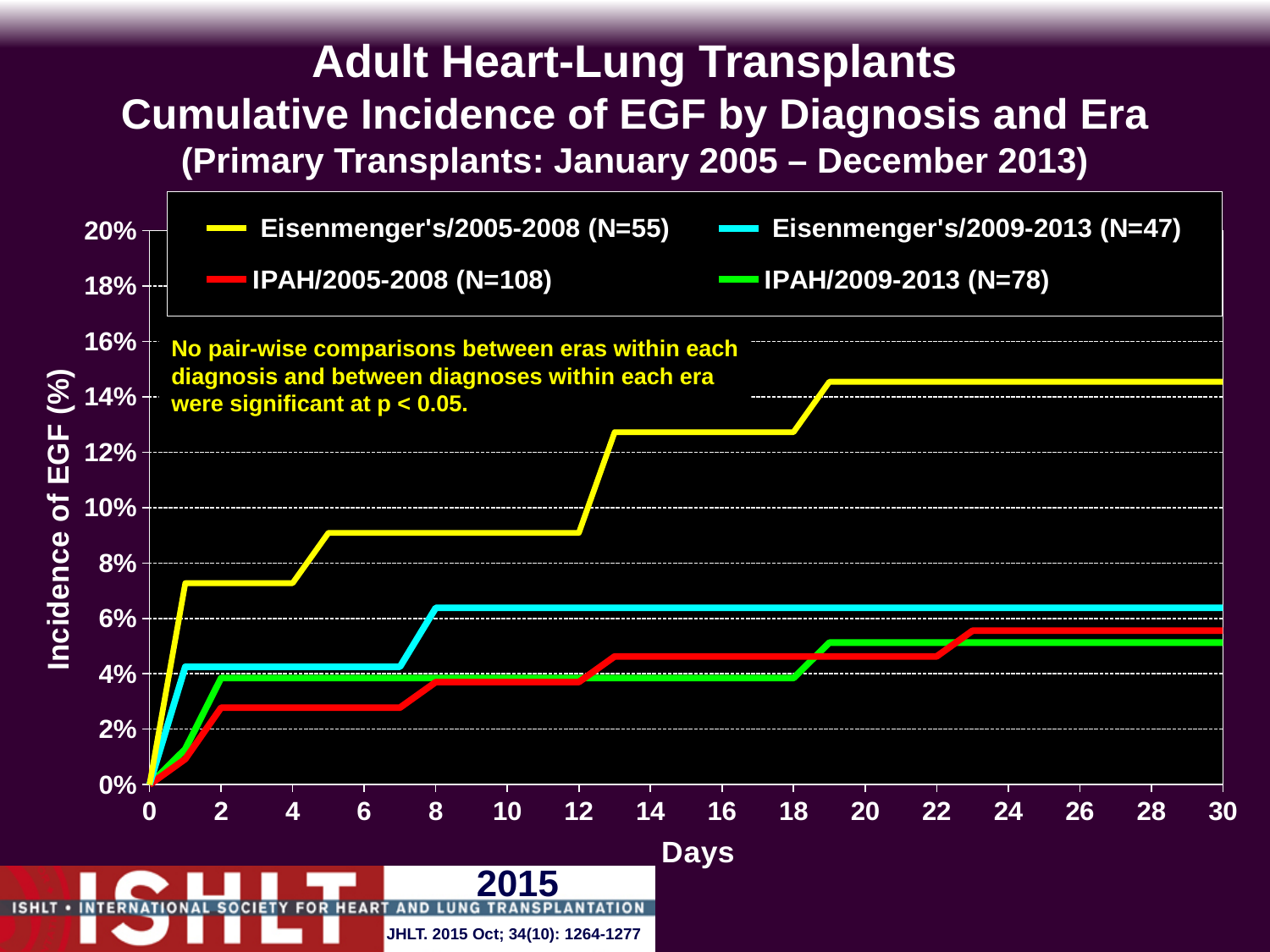
How many series does the legend list? 4 Which series has the highest cumulative incidence of EGF at day 30? Eisenmenger's/2005-2008 (N=55) Is the value for Eisenmenger's/2005-2008 at day 30 greater or less than 12%? greater Is the value for Eisenmenger's/2009-2013 at day 30 greater or less than 8%? less Does the cumulative incidence of EGF for Eisenmenger's/2005-2008 rise or fall as days increase? Rise What kind of chart is shown on the slide? Line chart At day 10, which is higher: Eisenmenger's/2009-2013 or IPAH/2005-2008? Eisenmenger's/2009-2013 Is the value for IPAH/2005-2008 at day 4 greater or less than 4%? less What is the label of the x axis? Days At day 30, which is higher: Eisenmenger's/2005-2008 or IPAH/2009-2013? Eisenmenger's/2005-2008 What is the N for the IPAH/2005-2008 series in the legend? 108